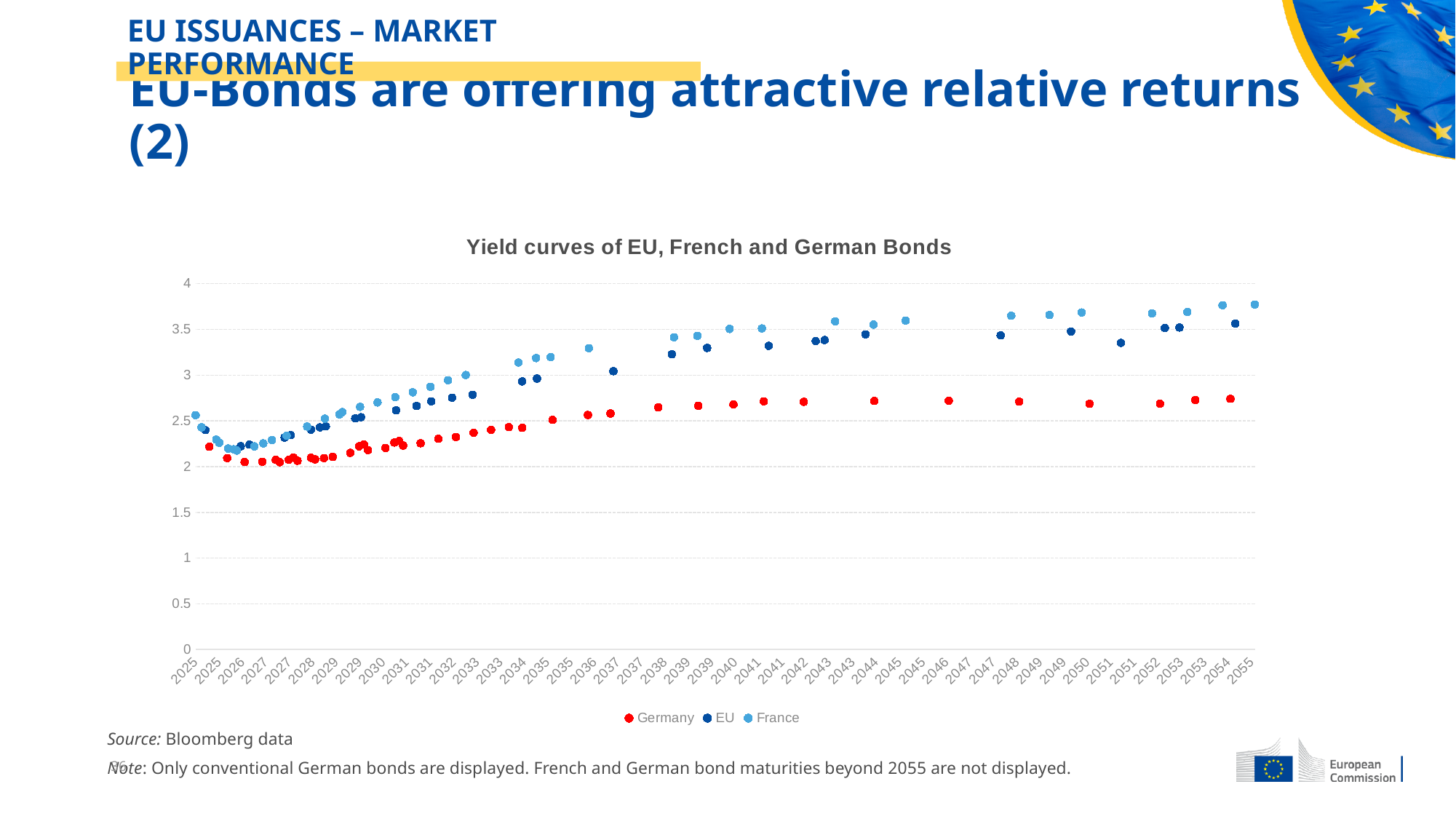
What kind of chart is shown on the slide? scatter chart Is the value for France at 2055 greater or less than 3.5? greater Is the value for Germany at 2055 greater or less than 3? less Which series has the highest yield at 2055? France Which colour represents Germany in the chart? red How many series does the legend of the chart list? 3 Is the value for Germany at 2040 greater or less than 2.5? greater Which is larger at 2055, the value for France or the value for Germany? France What is the title of the chart? Yield curves of EU, French and German Bonds Which series has the lowest yield at 2055? Germany